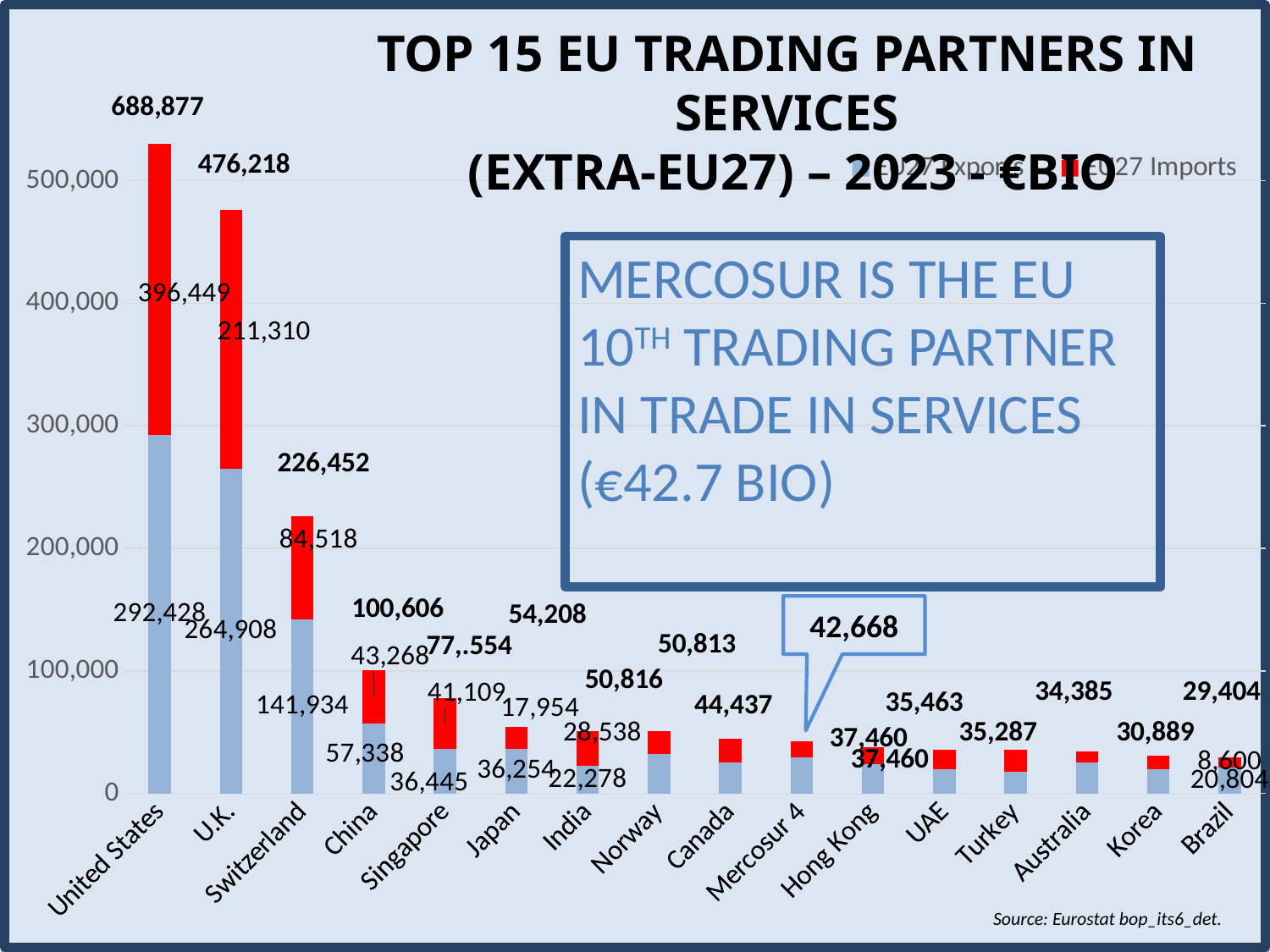
What is the value labelled for Mercosur 4? 42,668 Which trading partner has the highest total value? United States Which has the larger total value, Switzerland or China? Switzerland How many series does the legend list? 2 What is the total value labelled for the U.K.? 476,218 What is the difference between EU27 Imports and EU27 Exports for the United States? 104,021 Do the total values rise or fall moving from left to right along the x axis? Fall What kind of chart is shown on the slide? Stacked bar chart How many trading partners are plotted along the x axis? 16 What is the total value labelled for the United States? 688,877 What is the EU27 Exports value for the United States? 292,428 Is the total value for Norway greater or less than 100,000? less